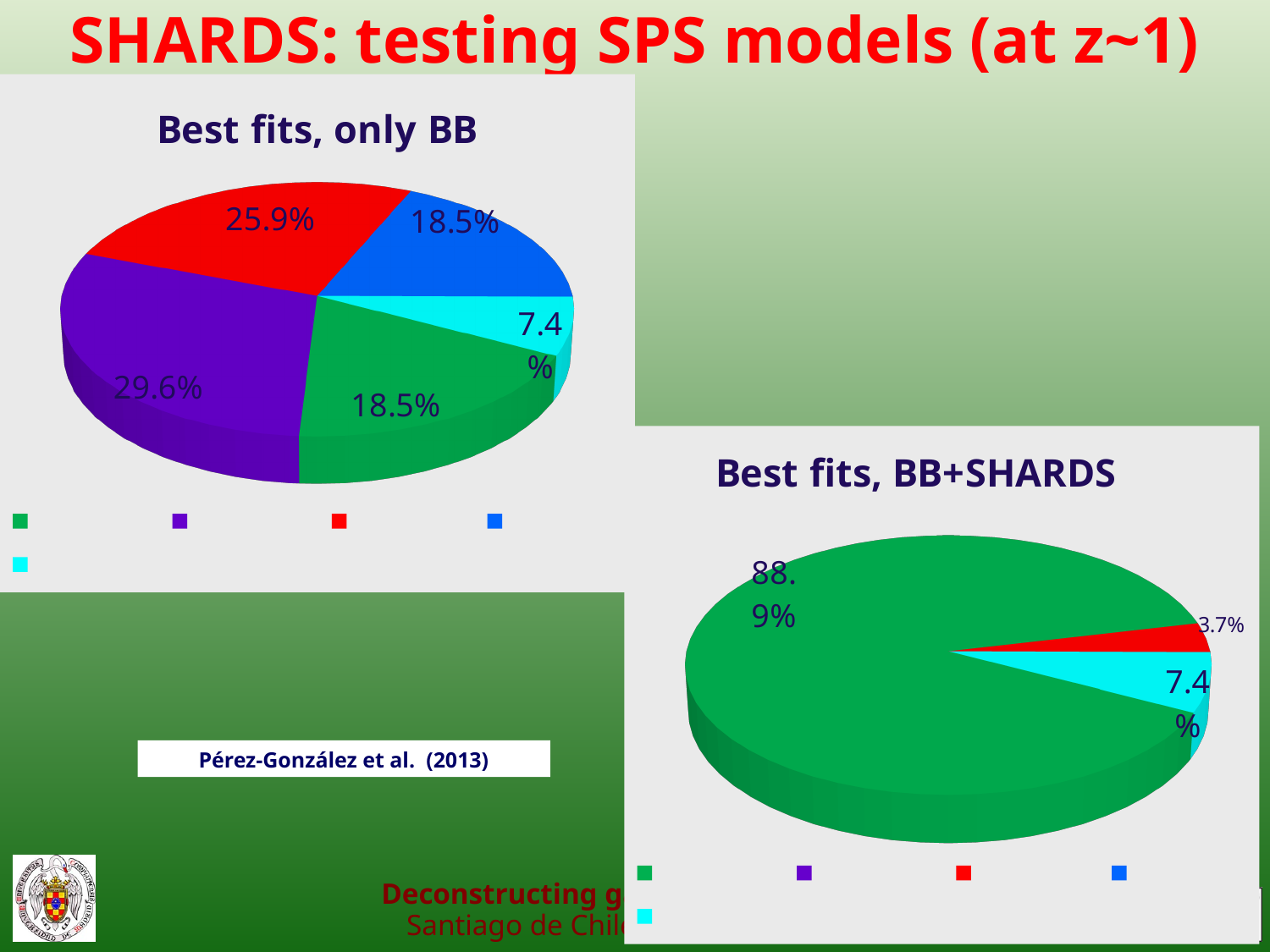
In the "Best fits, only BB" pie chart, how many slices are there? 5 What is the title of the pie chart on the right side of the slide? Best fits, BB+SHARDS In the "Best fits, BB+SHARDS" pie chart, which is larger, the cyan slice or the red slice? cyan In the "Best fits, only BB" pie chart, what percentage is shown for the purple slice? 29.6% What kind of chart is shown under the title "Best fits, only BB"? pie chart In the "Best fits, only BB" pie chart, which colour slice has the largest share? purple In the "Best fits, only BB" pie chart, what percentage is shown for the red slice? 25.9% In the "Best fits, BB+SHARDS" pie chart, what percentage is shown for the green slice? 88.9% In the "Best fits, only BB" pie chart, which colour slice has the smallest share? cyan In the "Best fits, only BB" pie chart, what is the difference between the purple slice and the red slice? 3.7% In the "Best fits, BB+SHARDS" pie chart, what percentage is shown for the red slice? 3.7% In the "Best fits, only BB" pie chart, what percentage is shown for the cyan slice? 7.4%